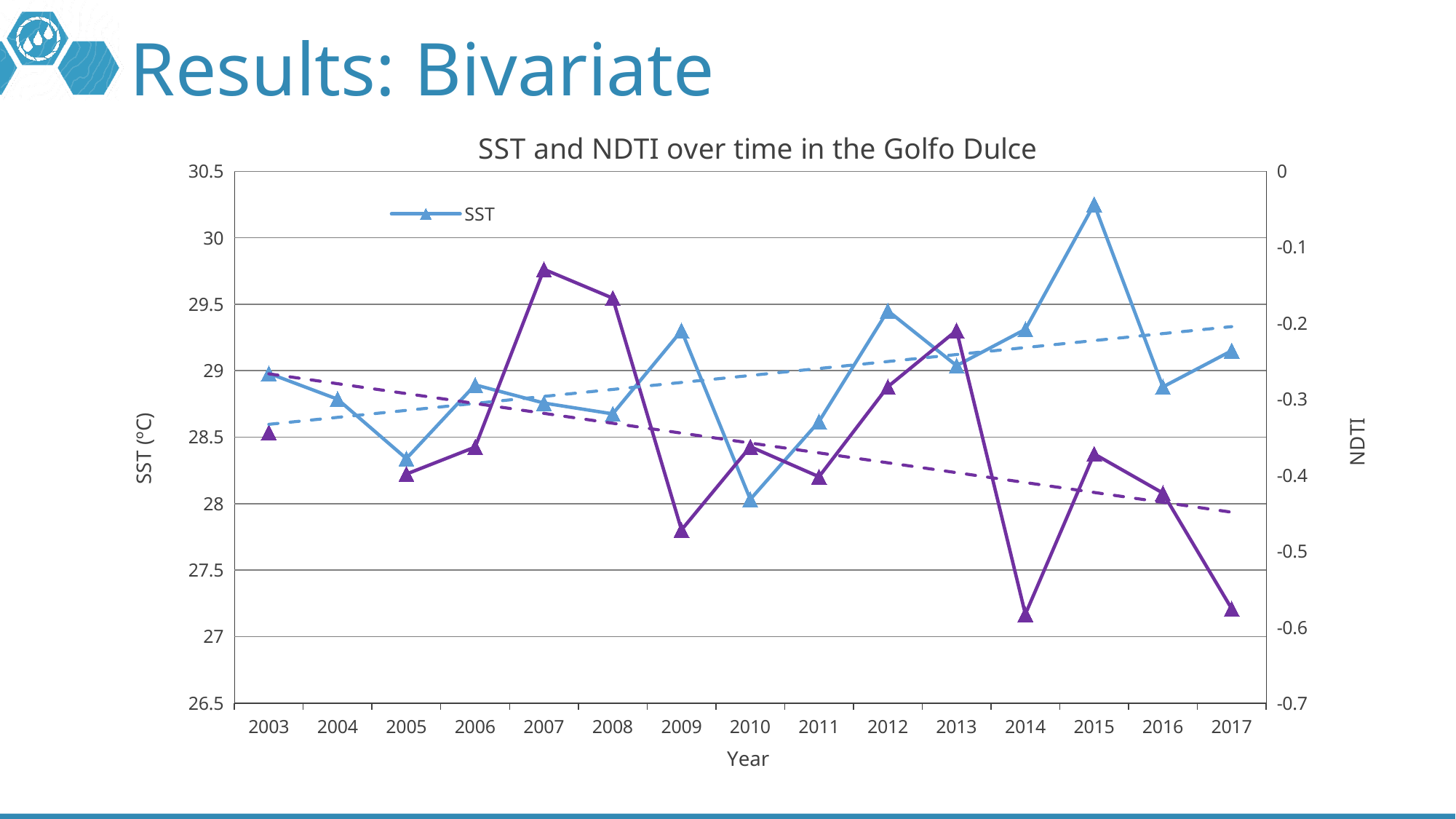
Does the dashed SST trend line rise or fall from 2003 to 2017? rise Which year has the lowest SST value? 2010 How many years are plotted along the x axis? 15 Is the SST value for 2015 greater or less than 30? greater Which year has the highest NDTI value on the purple line? 2007 What is the title of the chart? SST and NDTI over time in the Golfo Dulce Is the SST value for 2010 greater or less than 28.5? less What kind of chart is shown on the slide? line chart Is the SST value for 2009 greater or less than 29? greater Which year has the larger SST value, 2012 or 2013? 2012 How many series does the legend list? 1 Which year has the highest SST value? 2015